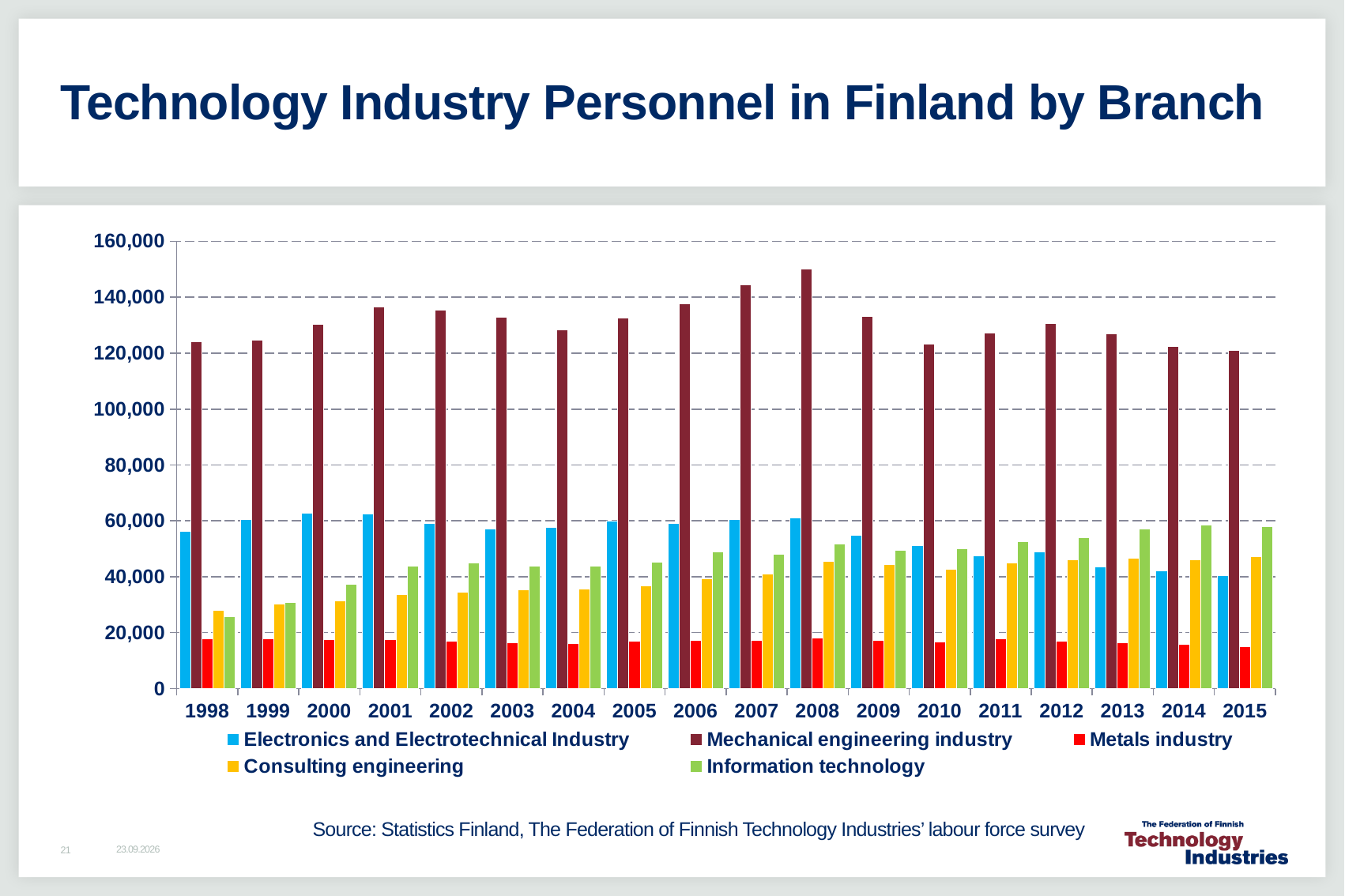
Is the value for Mechanical engineering industry in 2008 greater or less than 140,000? greater Is the value for Metals industry in 2008 greater or less than 20,000? less How many series does the legend list? 5 Is the value for Information technology in 1998 greater or less than 40,000? less In 2015, which is larger: Information technology or Electronics and Electrotechnical Industry? Information technology In which year is the Consulting engineering value lowest? 1998 In which year is the Information technology value lowest? 1998 What kind of chart is shown on the slide? Bar chart How many years are shown on the x axis? 18 Does the Information technology series generally rise or fall from 1998 to 2015? Rise In which year is the Mechanical engineering industry value highest? 2008